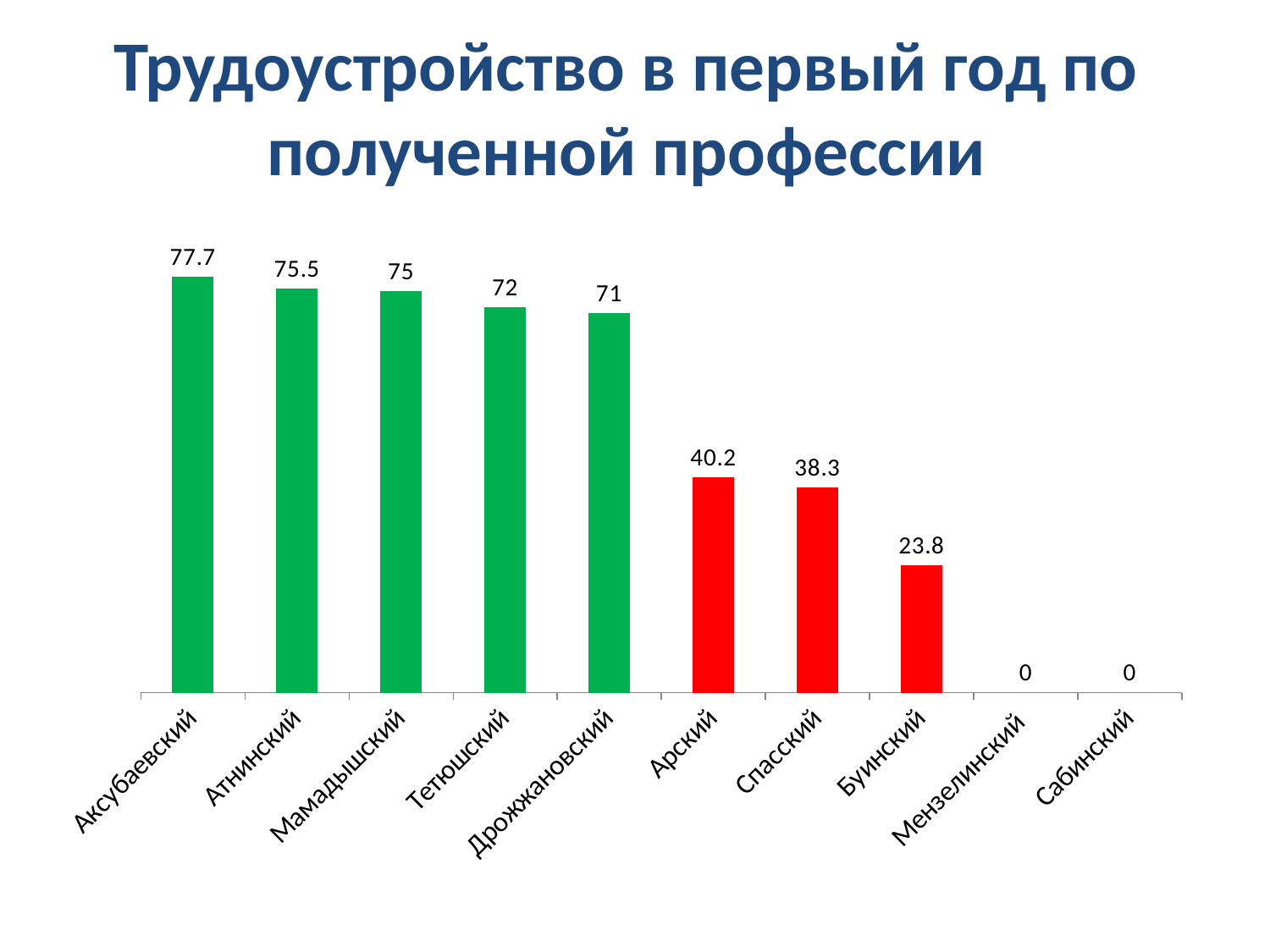
What is the difference between the values for Аксубаевский and Атнинский? 2.2 What kind of chart is shown on the slide? Bar chart What is the value for Буинский? 23.8 How many bars are coloured red? 3 How many categories are shown on the x axis? 10 What is the difference between the values for Арский and Спасский? 1.9 What is the value for Дрожжановский? 71 Which category has the highest value? Аксубаевский What is the value for Спасский? 38.3 What is the value for Аксубаевский? 77.7 Do the values rise or fall from left to right along the x axis? Fall Which is larger, the value for Тетюшский or the value for Арский? Тетюшский